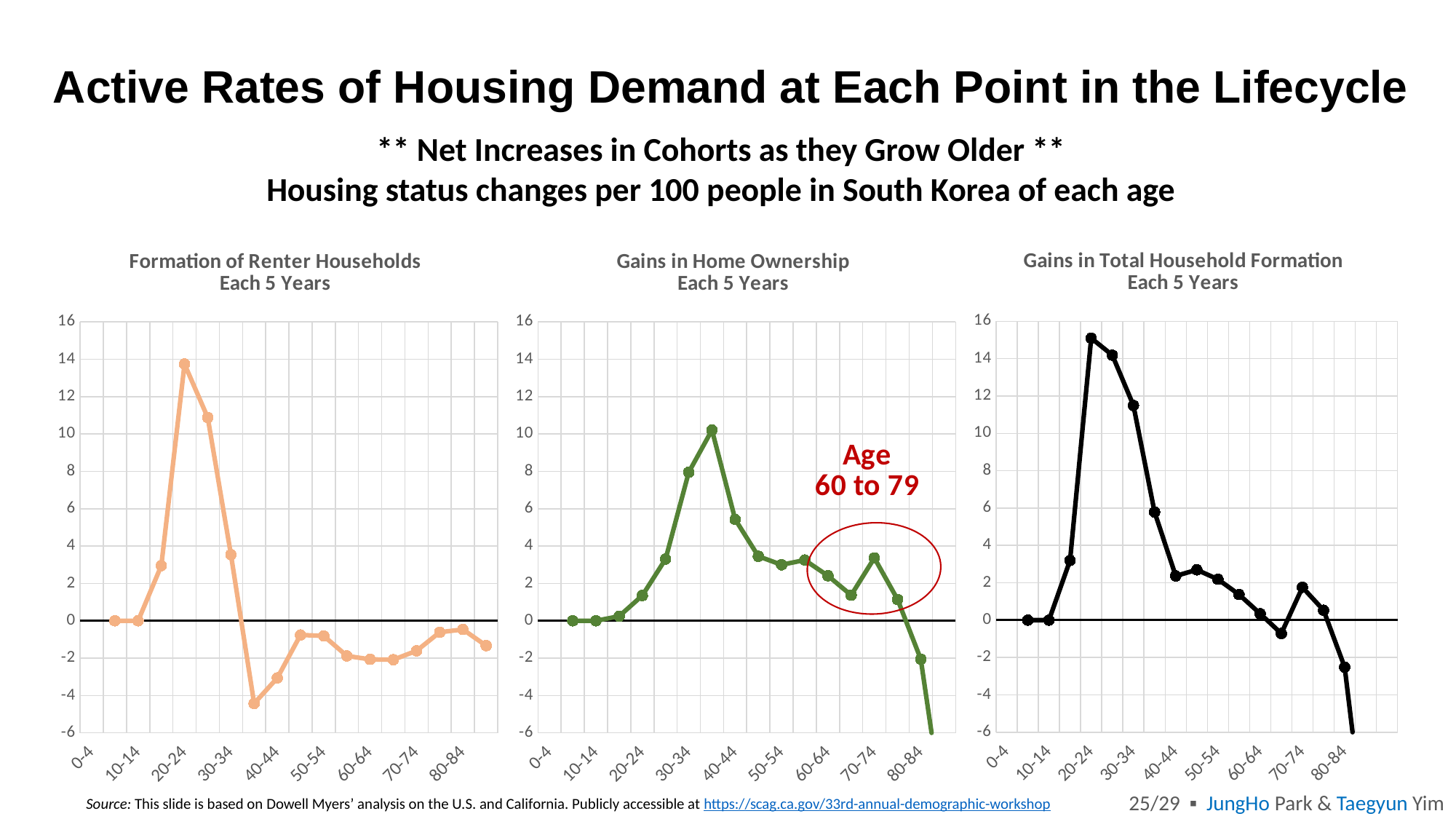
In the 'Formation of Renter Households Each 5 Years' chart, is the lowest point greater or less than -2? less How many charts are shown on the slide? 3 What is the range of the vertical axis on each chart? -6 to 16 In the 'Gains in Total Household Formation Each 5 Years' chart, do the values rise or fall from the peak near 20-24 to 40-44? fall Which of the three charts reaches the highest peak value? Gains in Total Household Formation Each 5 Years How many age-group labels are shown on the x axis of each chart? 9 What kind of chart is used for the three panels on this slide? Line chart What age range does the red annotation on the 'Gains in Home Ownership Each 5 Years' chart highlight? Age 60 to 79 In the 'Gains in Home Ownership Each 5 Years' chart, is the highest point greater or less than 8? greater In the 'Gains in Total Household Formation Each 5 Years' chart, is the highest point greater or less than 14? greater Is the peak of the 'Gains in Home Ownership Each 5 Years' chart higher or lower than the peak of the 'Gains in Total Household Formation Each 5 Years' chart? lower